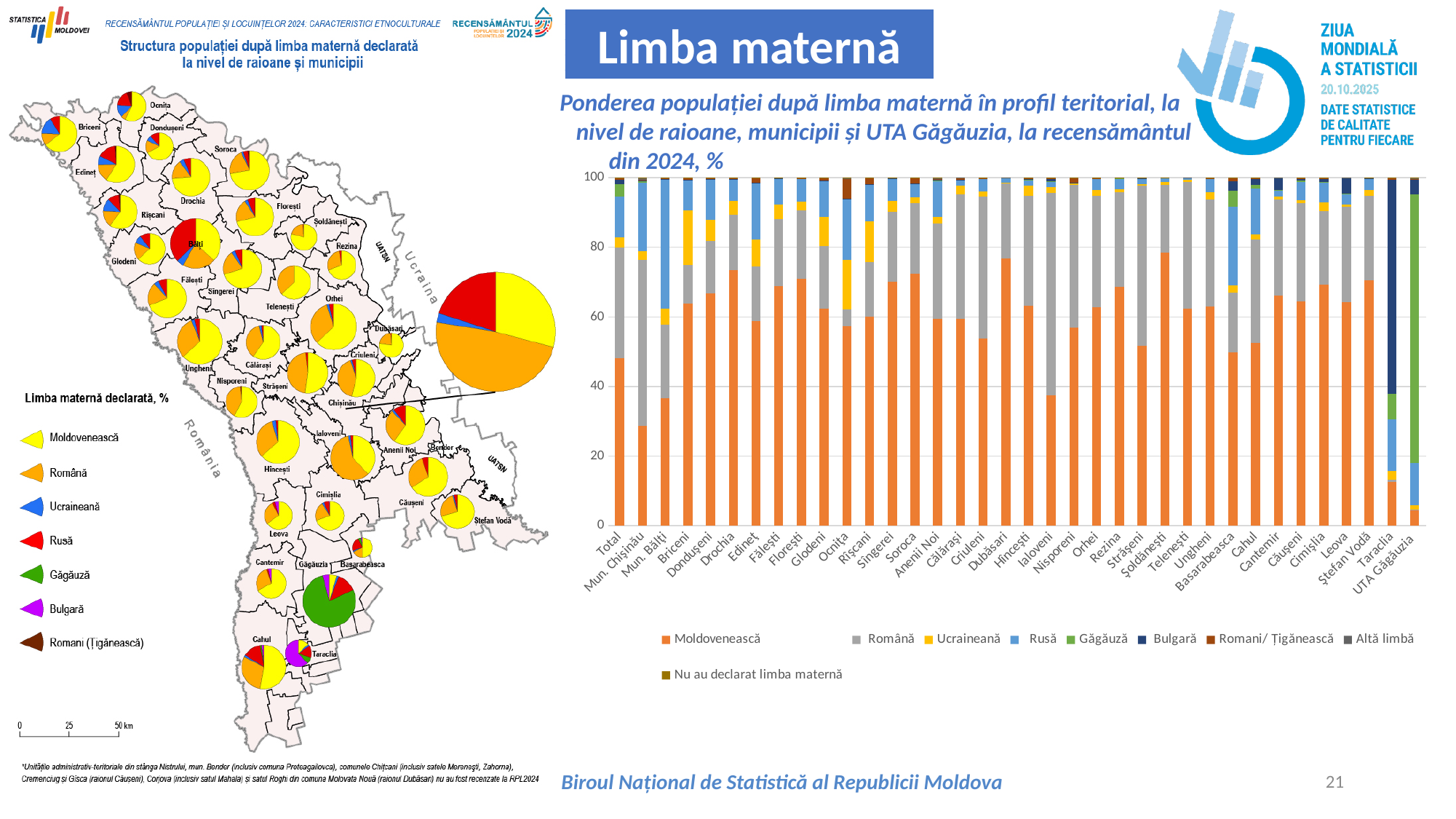
In the bar chart on the right, is the Moldovenească share for Taraclia greater or less than 20? less In the bar chart on the right, what value does each stacked bar add up to, as shown by the top of the y axis? 100 In the bar chart on the right, is the Moldovenească share for Dubăsari greater or less than 60? greater In the bar chart on the right, which has the larger Moldovenească share, Drochia or Briceni? Drochia In the bar chart on the right, which has the larger Moldovenească share, Mun. Chișinău or Mun. Bălți? Mun. Bălți What kind of chart is shown on the right side of the slide? stacked bar chart In the bar chart on the right, how many territorial categories are shown on the x axis (including Total)? 36 In the bar chart on the right, is the Moldovenească share for Șoldănești greater or less than 60? greater In the bar chart on the right, which colour represents Găgăuză in the legend? green In the bar chart on the right, which category has the lowest Moldovenească share? UTA Găgăuzia In the bar chart on the right, how many series does the legend list? 9